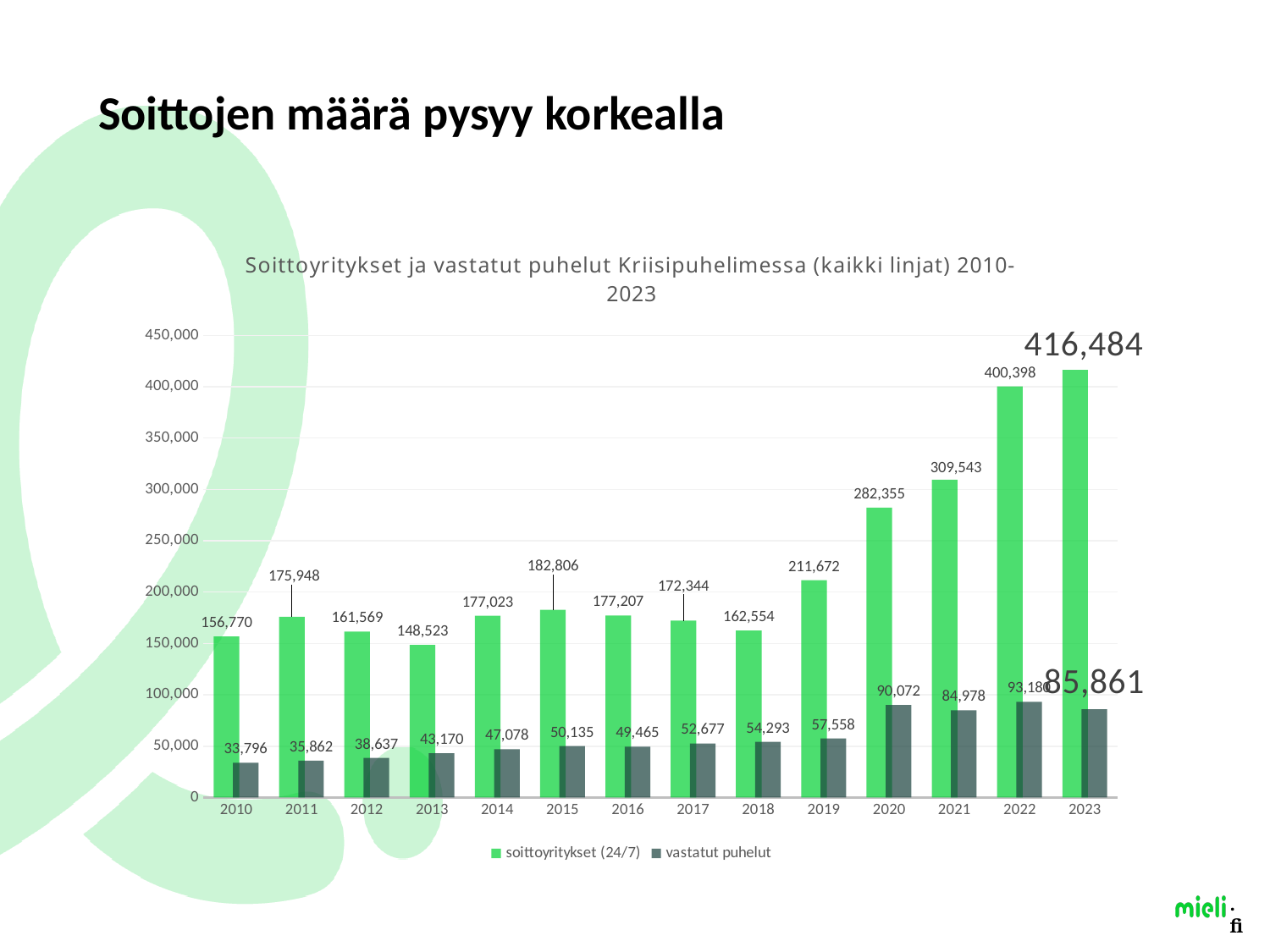
Is the value for soittoyritykset (24/7) in 2019 greater or less than 200,000? greater Which year has the lowest value for soittoyritykset (24/7)? 2013 What is the value for soittoyritykset (24/7) in 2023? 416,484 Which year has the larger value for vastatut puhelut, 2020 or 2021? 2020 Which year has the lowest value for vastatut puhelut? 2010 What kind of chart is shown on the slide? bar chart What is the value for vastatut puhelut in 2020? 90,072 How many years are shown on the x axis? 14 Which year has the highest value for soittoyritykset (24/7)? 2023 What is the difference between soittoyritykset (24/7) in 2023 and in 2022? 16,086 What is the difference between soittoyritykset (24/7) and vastatut puhelut in 2023? 330,623 How many series does the legend list? 2